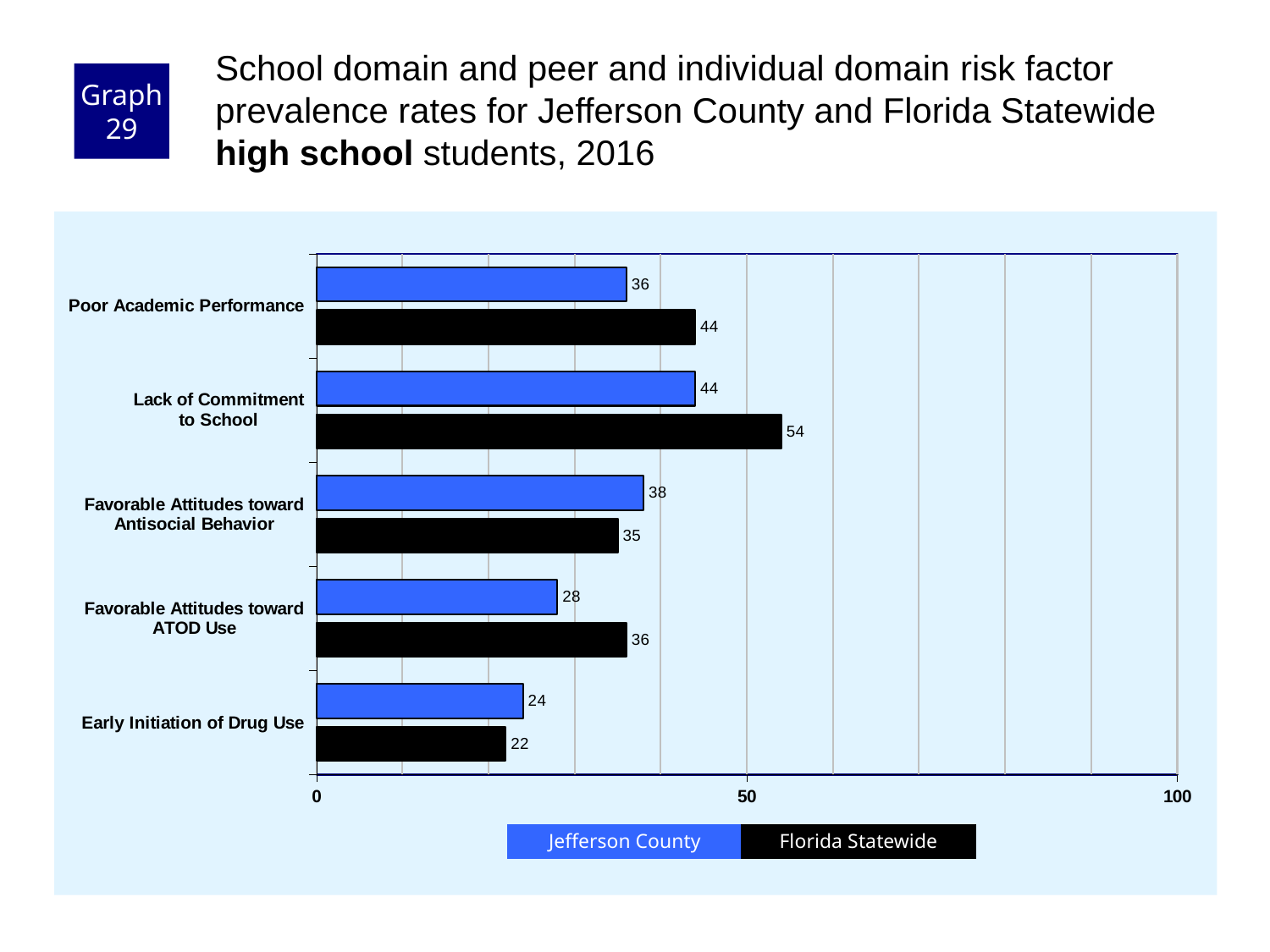
Which risk factor has the highest Florida Statewide value? Lack of Commitment to School What is the difference between the Florida Statewide and Jefferson County values for Favorable Attitudes toward ATOD Use? 8 Which colour represents Florida Statewide in the chart? black For Favorable Attitudes toward Antisocial Behavior, which is larger: Jefferson County or Florida Statewide? Jefferson County What is the Florida Statewide value for Lack of Commitment to School? 54 What is the Jefferson County value for Early Initiation of Drug Use? 24 How many risk factor categories are shown on the chart? 5 What is the Jefferson County value for Poor Academic Performance? 36 How many series does the legend list? 2 What kind of chart is shown on the slide? bar chart Which risk factor has the lowest Jefferson County value? Early Initiation of Drug Use Is the Florida Statewide value for Lack of Commitment to School greater or less than 50? greater